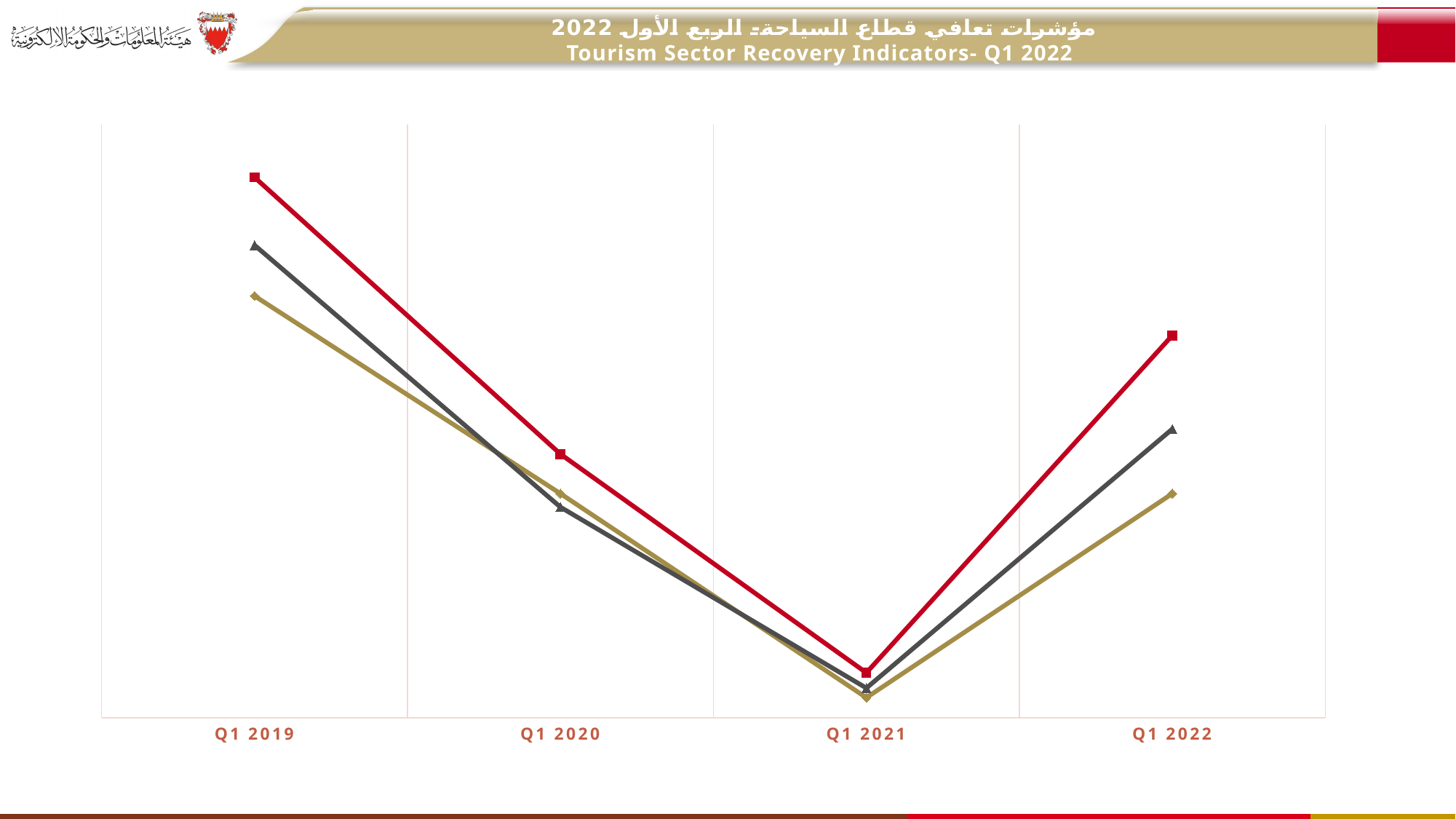
Which period has the highest value for the red line? Q1 2019 Which period has the lowest value for the red line? Q1 2021 At Q1 2022, which line is higher: the red line or the gold line? The red line For the red line, which is higher: the value at Q1 2019 or the value at Q1 2022? Q1 2019 What is the title of the chart on the slide (in English)? Tourism Sector Recovery Indicators- Q1 2022 Do the lines rise or fall from Q1 2019 to Q1 2021? Fall How many time periods are shown on the x axis of the chart? 4 How many lines are plotted on the chart? 3 What kind of chart is shown on the slide? Line chart Do the lines rise or fall from Q1 2021 to Q1 2022? Rise Which period has the highest value for the dark gray line? Q1 2019 Which period has the lowest value for the gold line? Q1 2021